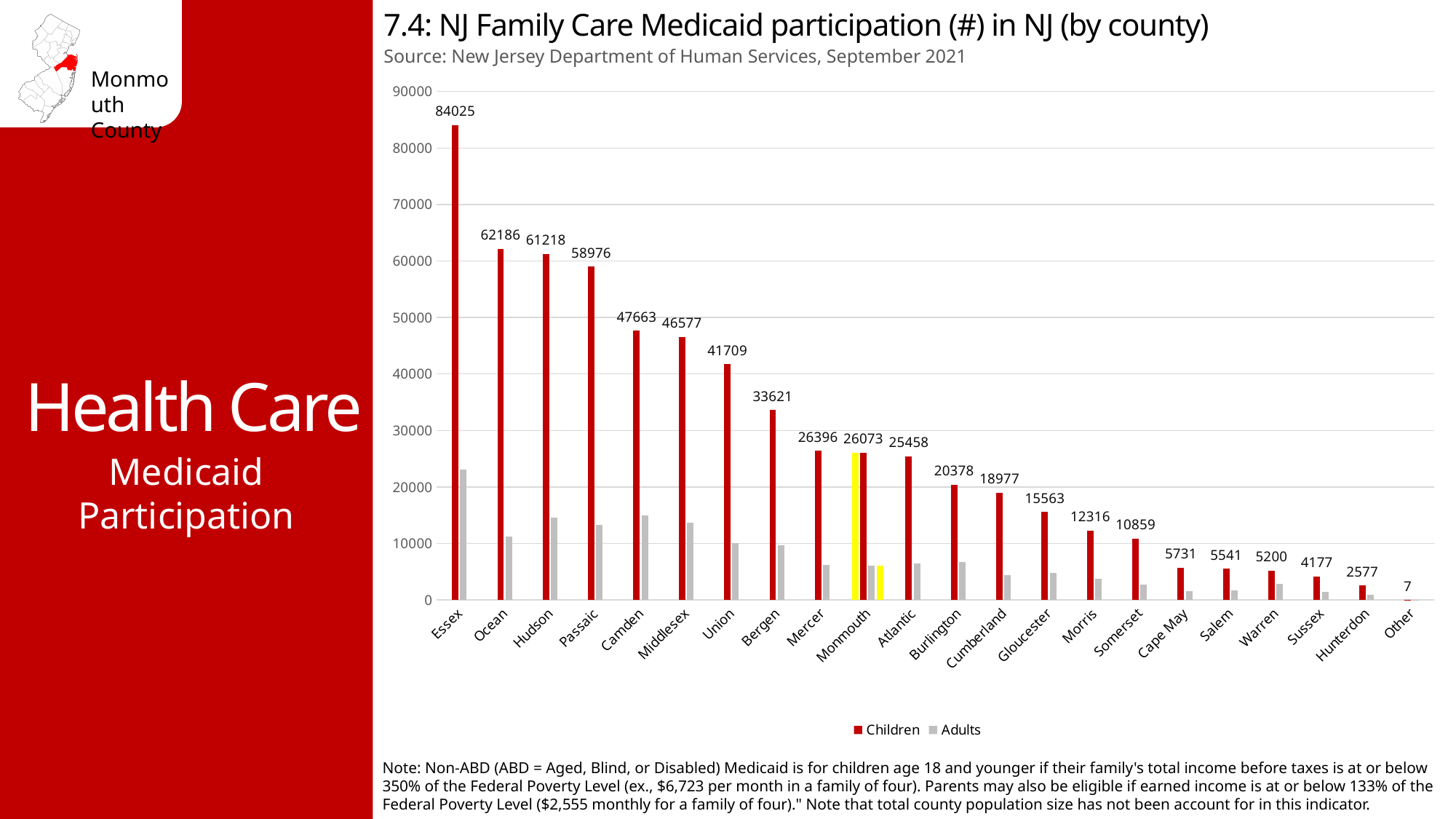
How many series does the legend list? 2 What is the Children value for Monmouth? 26073 Which category has the highest Children value? Essex What kind of chart is shown on the slide? bar chart How many categories are shown on the x axis? 22 Is the Adults value for Essex greater or less than 20000? greater Which category has the lowest Children value? Other What is the Children value for Essex? 84025 Do the Children values rise or fall from left to right along the x axis? fall What is the difference between the Children values for Ocean and Hudson? 968 Which has a larger Children value, Camden or Middlesex? Camden What is the Children value for Hunterdon? 2577